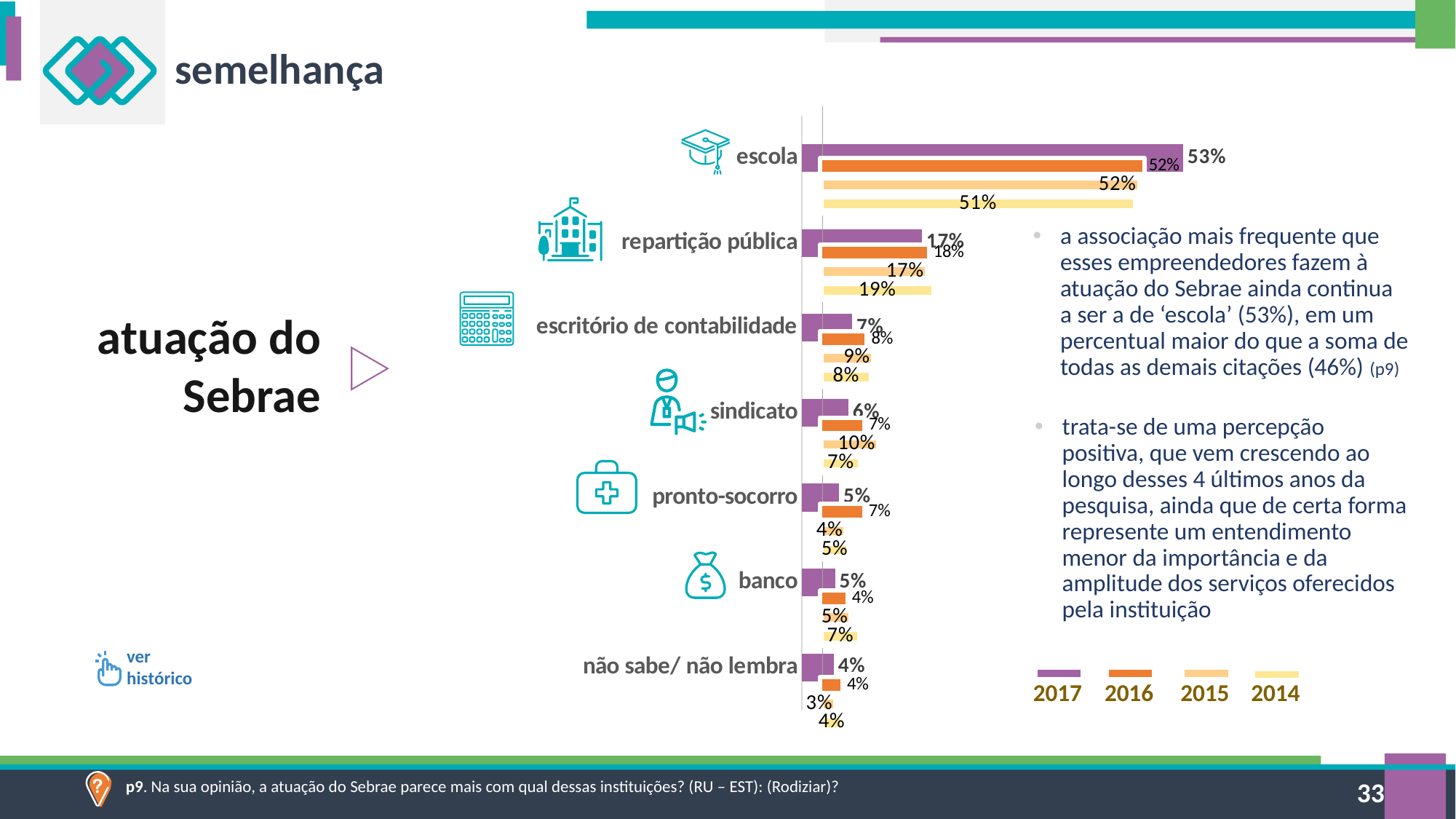
Which category has the lowest value in 2015? não sabe/ não lembra How many series does the legend list? 4 Which category has the highest value in 2017? escola What is the value for sindicato in 2015? 10% What is the value for repartição pública in 2014? 19% Which year does the purple series represent in the legend? 2017 What is the difference between the 2017 values for escola and repartição pública? 36% Which is larger for pronto-socorro: the 2016 value or the 2015 value? 2016 How many categories are shown in the chart? 7 What is the value for banco in 2016? 4% What kind of chart is shown on the slide? bar chart What is the value for escola in 2017? 53%